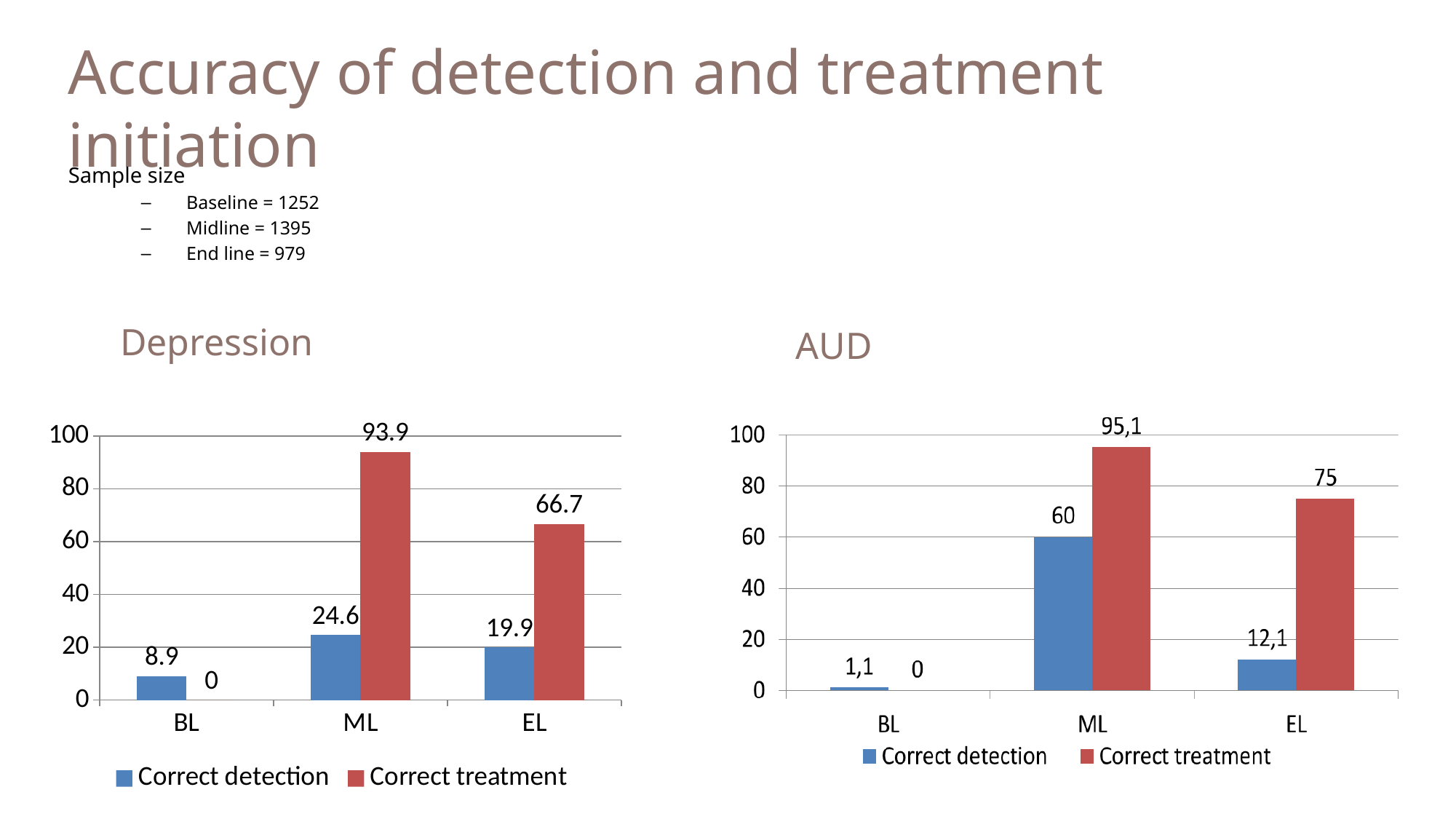
How many series does the legend of the Depression chart list? 2 In the AUD chart, what is the value for Correct detection at ML? 60 In the Depression chart, which category has the highest Correct detection value? ML In the Depression chart, what colour are the Correct treatment bars? Red What kind of chart is the AUD chart? Bar chart In the Depression chart, what is the value for Correct detection at BL? 8.9 In the Depression chart, what is the value for Correct treatment at ML? 93.9 In the AUD chart, what is the value for Correct treatment at EL? 75 In the AUD chart, which category has the lowest Correct detection value? BL In the Depression chart, what is the difference between Correct treatment at ML and at EL? 27.2 In the AUD chart, which is larger: Correct detection at ML or Correct treatment at EL? Correct treatment at EL How many categories are shown on the x axis of the AUD chart? 3